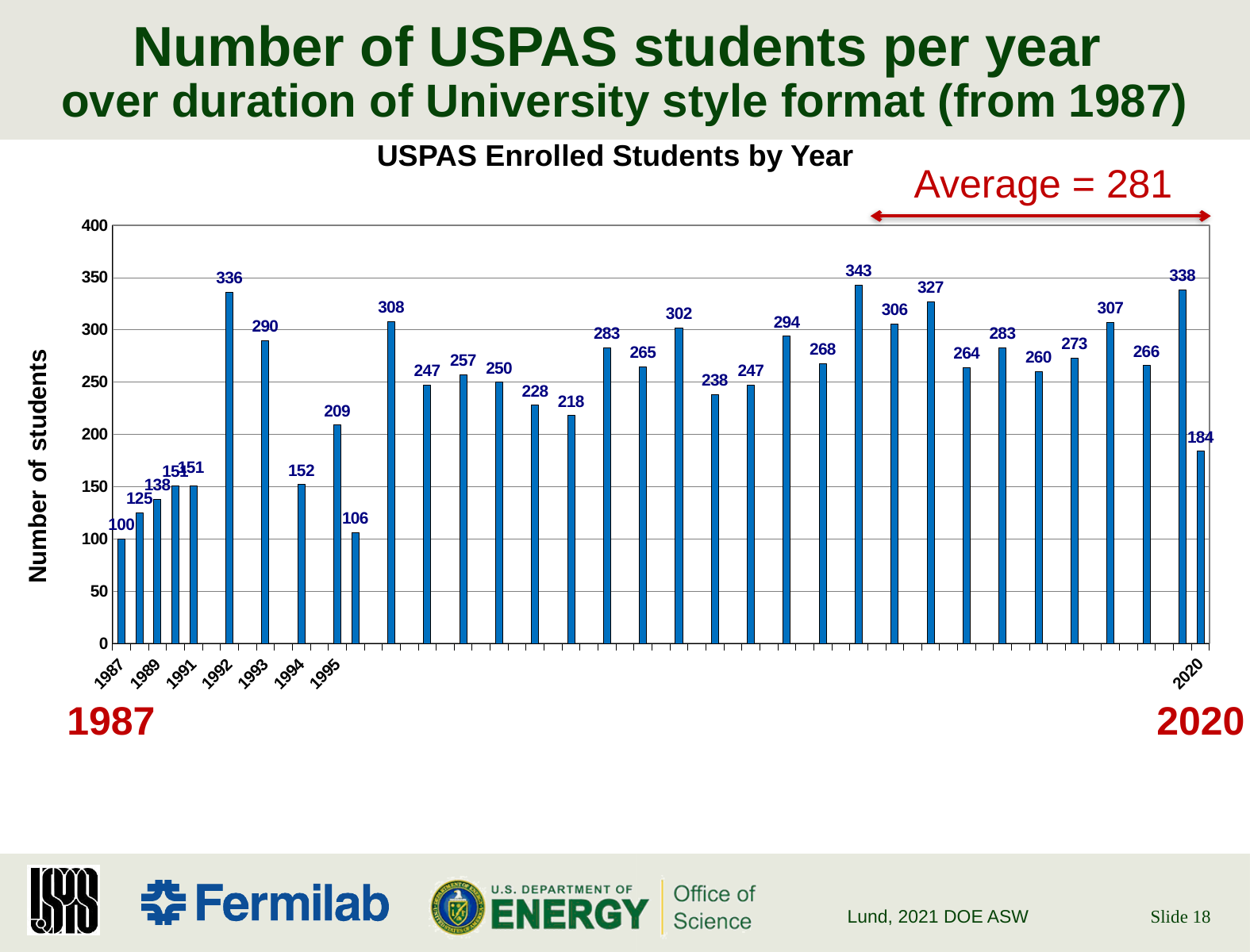
What is the number of students for 2020? 184 Is the value for 2020 greater or less than 200? less Which year has the lowest number of students? 1987 What kind of chart is shown on the slide? bar chart What is the highest number of students shown for any year? 343 What average value is annotated on the chart? 281 What is the difference in number of students between 1992 and 1993? 46 What is the number of students for 1995? 209 Which year has more students, 1994 or 1995? 1995 What is the number of students for 1992? 336 How many bars (years) are plotted in the chart? 34 What is the number of students for 1987? 100